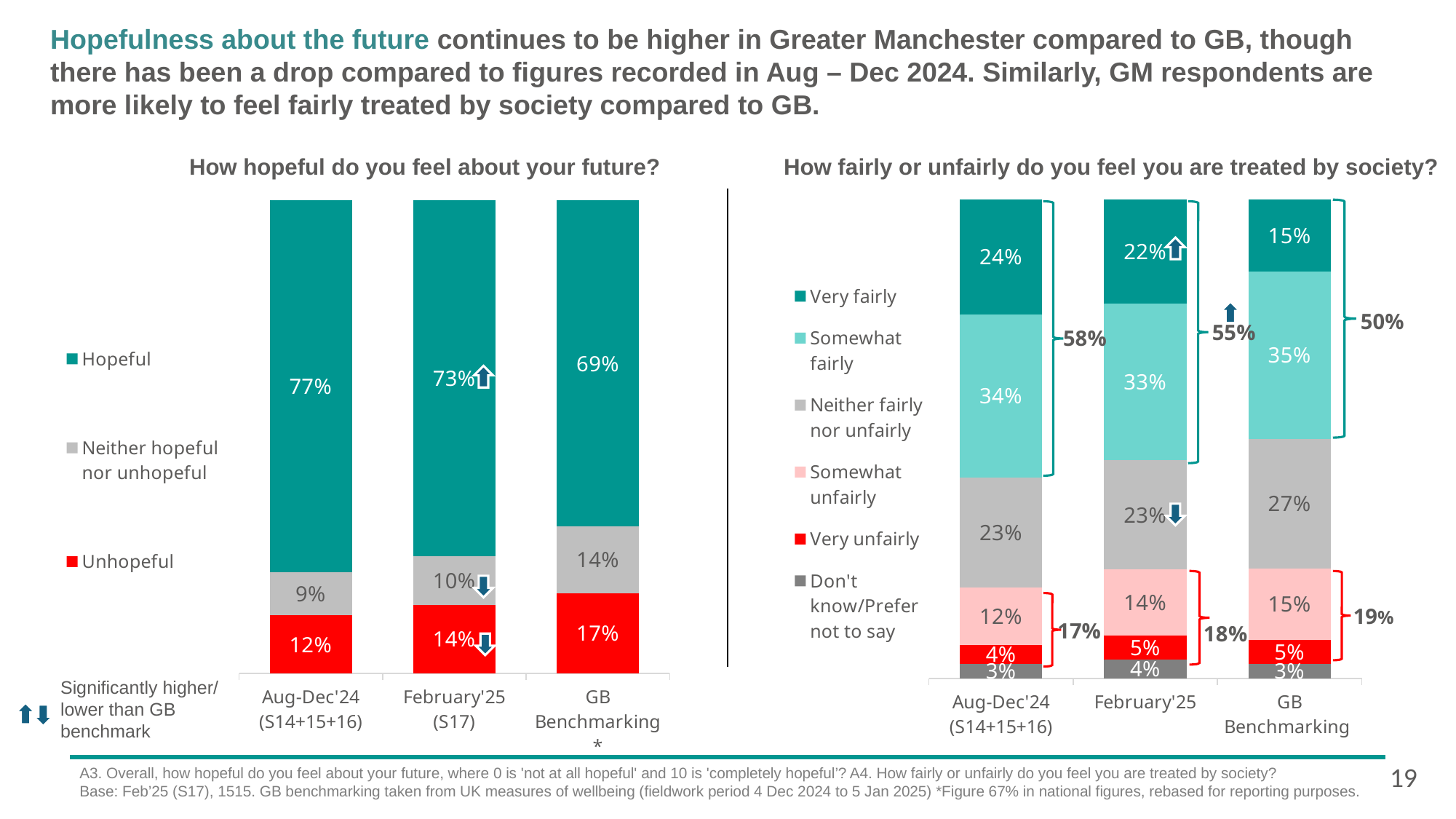
In the chart 'How fairly or unfairly do you feel you are treated by society?', how many series does the legend list? 6 In the chart 'How fairly or unfairly do you feel you are treated by society?', what is the combined Very fairly and Somewhat fairly percentage shown for Aug-Dec'24? 58% In the chart 'How hopeful do you feel about your future?', how many series does the legend list? 3 In the chart 'How hopeful do you feel about your future?', what is the Unhopeful value for GB Benchmarking? 17% In the chart 'How fairly or unfairly do you feel you are treated by society?', which category has the lowest Very fairly percentage? GB Benchmarking In the chart 'How fairly or unfairly do you feel you are treated by society?', is the Neither fairly nor unfairly value larger for February'25 or for GB Benchmarking? GB Benchmarking In the chart 'How hopeful do you feel about your future?', what is the difference between the Hopeful percentage for Aug-Dec'24 and for GB Benchmarking? 8 percentage points In the chart 'How hopeful do you feel about your future?', what percentage of respondents were Hopeful in February'25 (S17)? 73% In the chart 'How fairly or unfairly do you feel you are treated by society?', what is the Very fairly value for February'25? 22% In the chart 'How hopeful do you feel about your future?', which category has the highest Hopeful percentage? Aug-Dec'24 (S14+15+16) What type of chart is 'How fairly or unfairly do you feel you are treated by society?'? Stacked bar chart In the chart 'How fairly or unfairly do you feel you are treated by society?', what percentage of GB Benchmarking respondents said Somewhat fairly? 35%